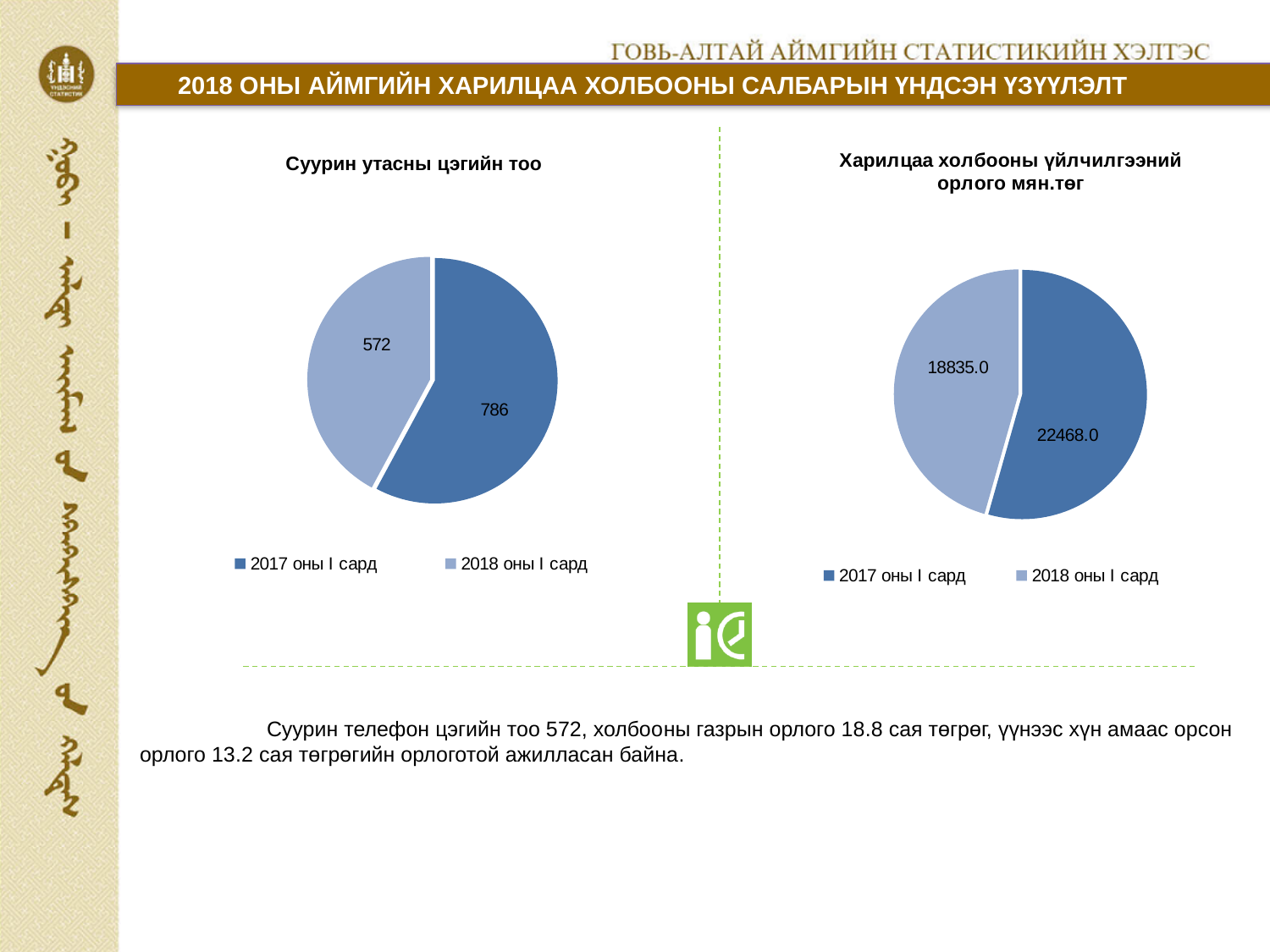
In the right chart (Харилцаа холбооны үйлчилгээний орлого мян.төг), which is larger: 2017 оны I сард or 2018 оны I сард? 2017 оны I сард How many slices does the left chart (Суурин утасны цэгийн тоо) have? 2 In the left chart (Суурин утасны цэгийн тоо), which slice is the largest? 2017 оны I сард How many entries does the legend of the right chart (Харилцаа холбооны үйлчилгээний орлого мян.төг) list? 2 In the right chart (Харилцаа холбооны үйлчилгээний орлого мян.төг), which slice is the smallest? 2018 оны I сард In the chart titled "Харилцаа холбооны үйлчилгээний орлого мян.төг", what is the value for 2017 оны I сард? 22468.0 In the chart titled "Харилцаа холбооны үйлчилгээний орлого мян.төг", what is the value for 2018 оны I сард? 18835.0 In the chart titled "Суурин утасны цэгийн тоо", what is the value for 2018 оны I сард? 572 In the chart titled "Суурин утасны цэгийн тоо", what is the value for 2017 оны I сард? 786 In the left chart (Суурин утасны цэгийн тоо), what is the difference between the 2017 оны I сард and 2018 оны I сард values? 214 In the right chart (Харилцаа холбооны үйлчилгээний орлого мян.төг), what is the difference between the 2017 оны I сард and 2018 оны I сард values? 3633.0 What type of chart is used for "Суурин утасны цэгийн тоо"? Pie chart